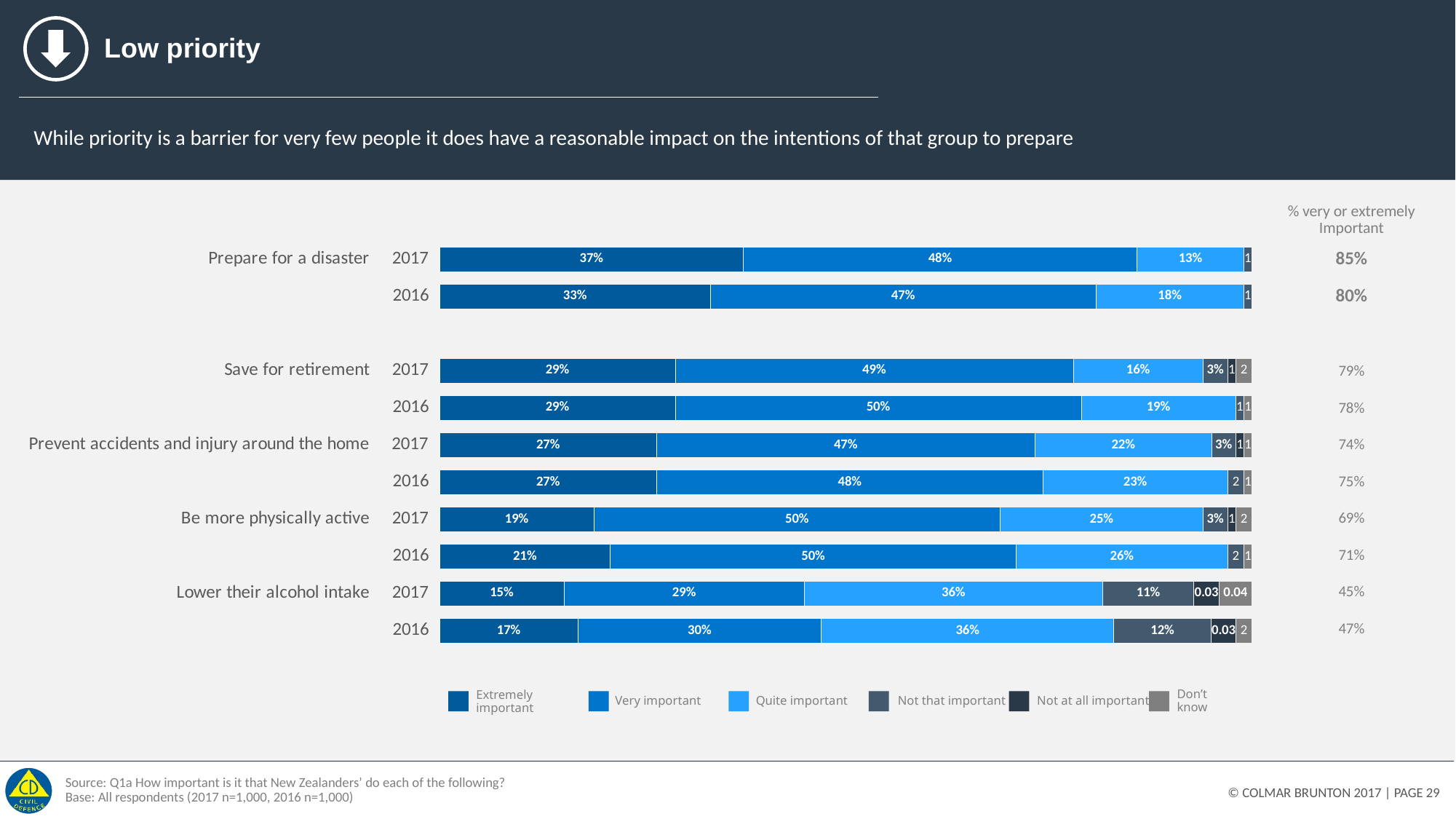
How many series does the legend list? 6 What is the Very important value for 'Save for retirement' in 2016? 50% What is the '% very or extremely Important' figure for 'Prepare for a disaster' in 2017? 85% What percentage of respondents rated 'Prepare for a disaster' as Extremely important in 2017? 37% What is the Not that important value for 'Lower their alcohol intake' in 2016? 12% Which bar has the lowest '% very or extremely Important' figure? Lower their alcohol intake 2017 What type of chart is shown on the slide? Stacked bar chart What is the Quite important value for 'Lower their alcohol intake' in 2017? 36% How many bars are shown in the chart? 10 Which is larger: the Very important value for 'Save for retirement' 2017 or for 'Lower their alcohol intake' 2017? Save for retirement 2017 Which bar has the highest Extremely important value? Prepare for a disaster 2017 By how many percentage points did the '% very or extremely Important' figure for 'Prepare for a disaster' change from 2016 to 2017? 5 percentage points